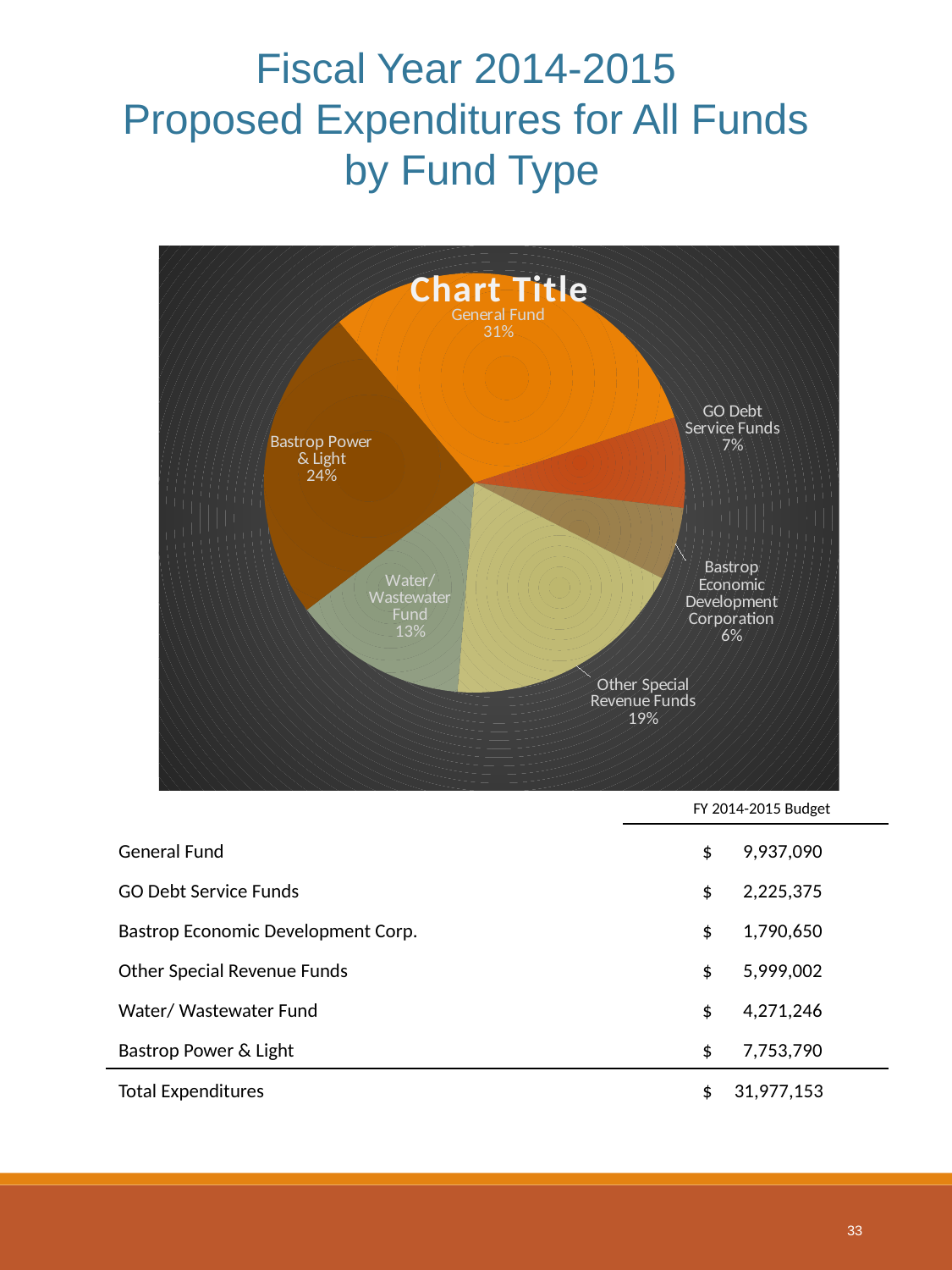
What share of the pie does the General Fund slice represent? 31% Which slice is larger, Other Special Revenue Funds or Water/Wastewater Fund? Other Special Revenue Funds What share of the pie does the GO Debt Service Funds slice represent? 7% What share of the pie does the Other Special Revenue Funds slice represent? 19% How many slices does the pie chart have? 6 Which fund type has the smallest slice of the pie? Bastrop Economic Development Corporation What kind of chart is shown on the slide? pie chart What is the difference in percentage points between the General Fund slice and the Bastrop Power & Light slice? 7 percentage points Which fund type has the largest slice of the pie? General Fund